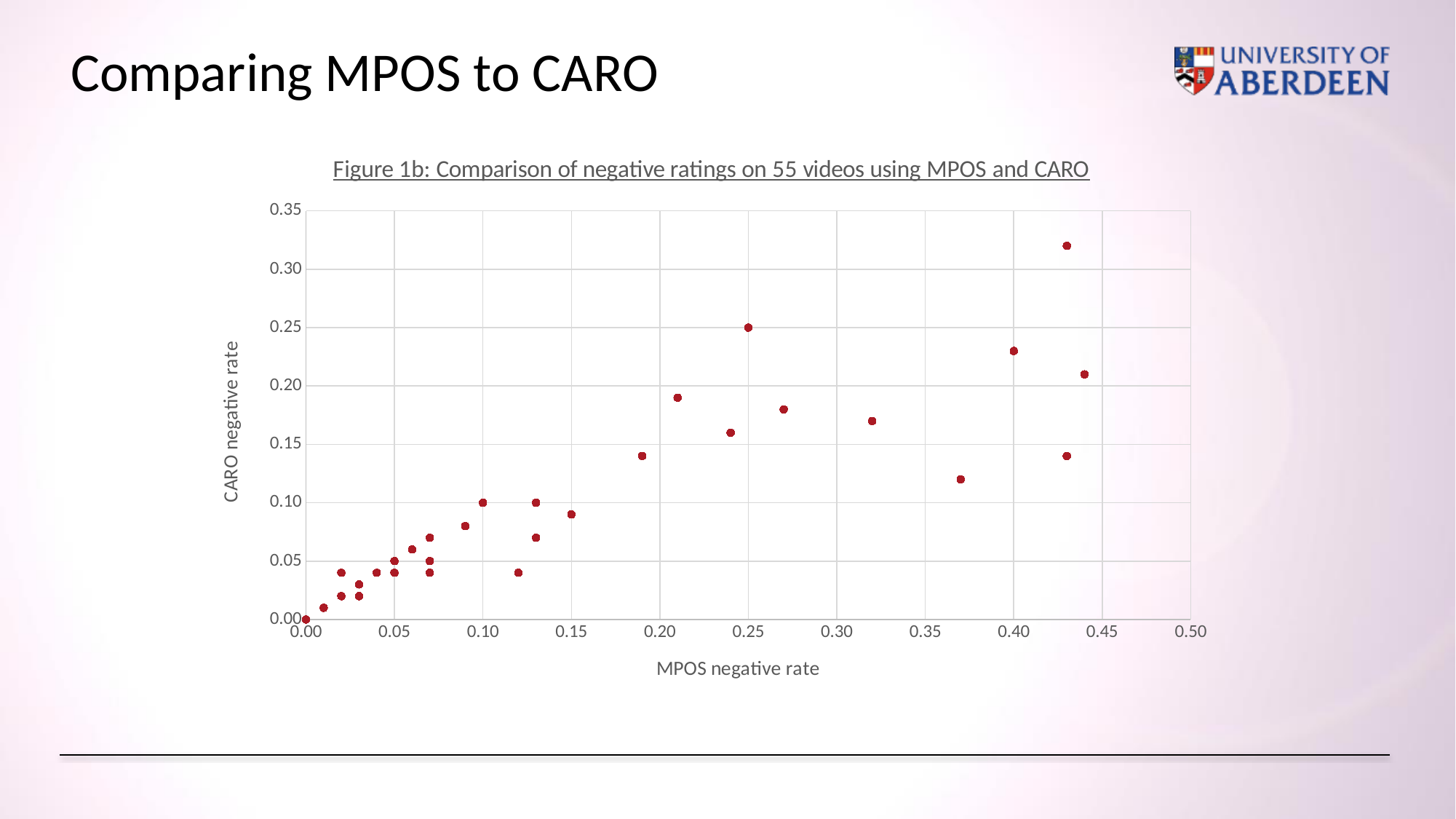
As the MPOS negative rate increases along the x axis, does the CARO negative rate generally rise or fall? rise What is the title of the chart? Figure 1b: Comparison of negative ratings on 55 videos using MPOS and CARO Is the CARO negative rate of the point at MPOS negative rate 0.37 greater or less than 0.15? less What is the label of the horizontal axis of the chart? MPOS negative rate Which has the higher CARO negative rate: the point at MPOS negative rate 0.25 or the point at MPOS negative rate 0.32? the point at 0.25 Is the CARO negative rate of the highest point on the chart greater or less than 0.35? less According to the chart title, how many videos were compared? 55 Is the CARO negative rate of the point at MPOS negative rate 0.40 greater or less than 0.20? greater What kind of chart is shown on the slide? scatter chart What is the CARO negative rate of the point plotted at an MPOS negative rate of 0.10? 0.10